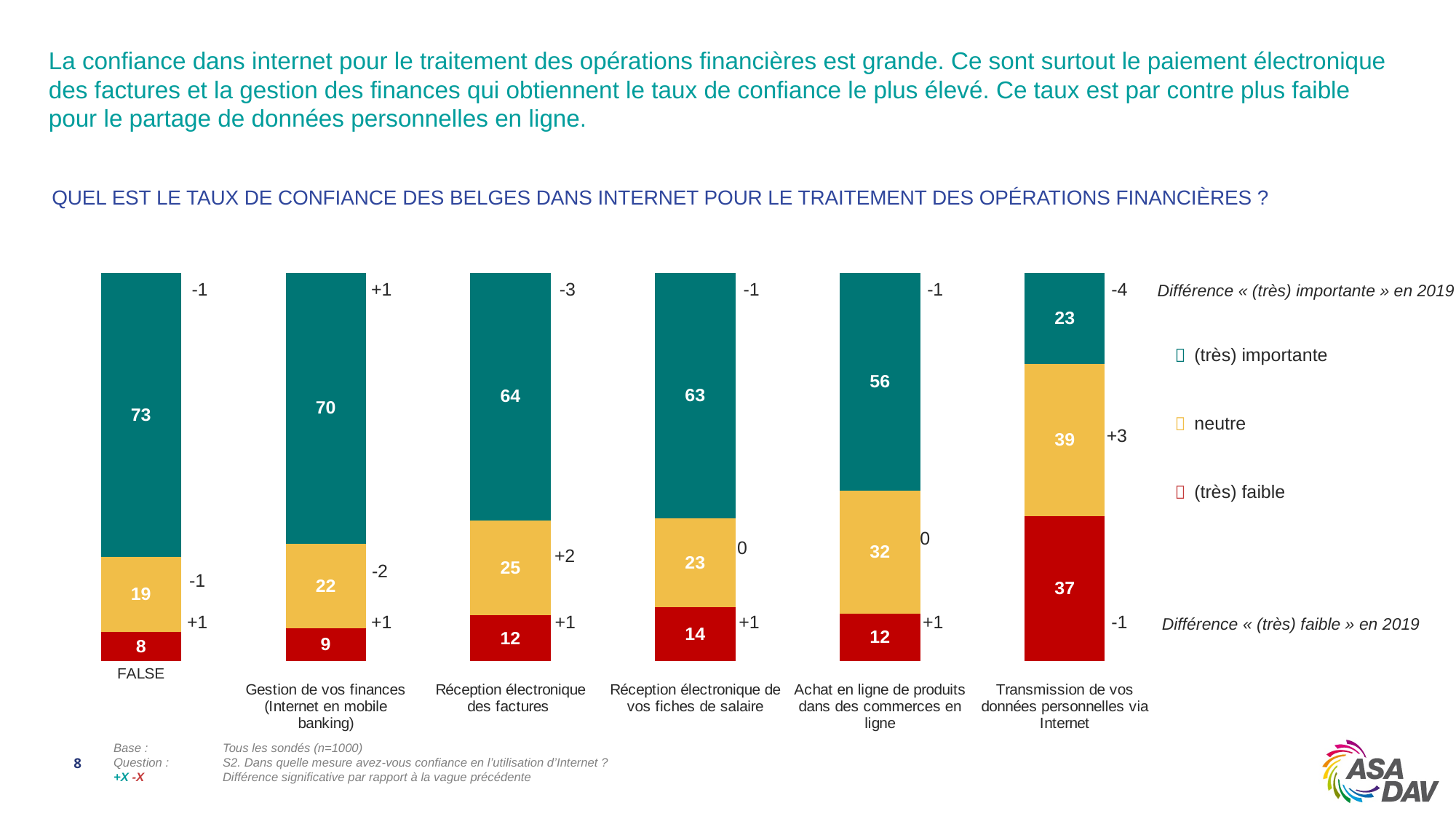
Which category has the highest 'neutre' value? Transmission de vos données personnelles via Internet Which legend entry is shown in red? (très) faible What is the difference between the '(très) importante' values for 'Réception électronique des factures' and 'Achat en ligne de produits dans des commerces en ligne'? 8 What is the '(très) faible' value for 'Transmission de vos données personnelles via Internet'? 37 What is the '(très) importante' value for 'Gestion de vos finances (Internet en mobile banking)'? 70 What is the total of the stacked bar for 'Réception électronique de vos fiches de salaire'? 100 What kind of chart is shown on the slide? stacked bar chart How many bars (categories) are plotted in the chart? 6 What is the 'neutre' value for 'Achat en ligne de produits dans des commerces en ligne'? 32 How many series does the legend list? 3 Which is larger: the '(très) faible' value for 'Réception électronique de vos fiches de salaire' or for 'Réception électronique des factures'? Réception électronique de vos fiches de salaire Which category has the lowest '(très) importante' value? Transmission de vos données personnelles via Internet